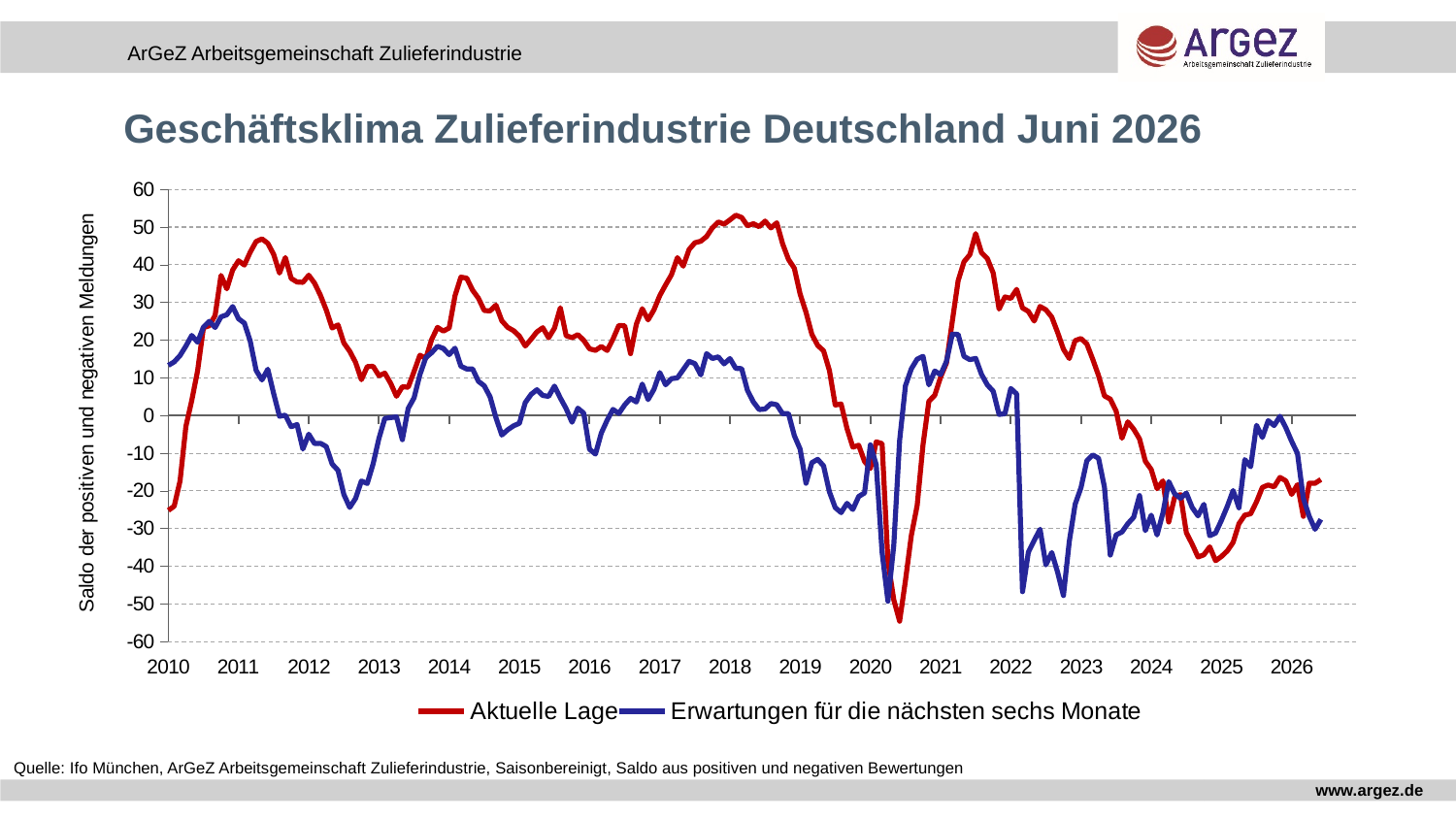
Which series is drawn in blue? Erwartungen für die nächsten sechs Monate What is the title of the chart? Geschäftsklima Zulieferindustrie Deutschland Juni 2026 How many series does the legend list? 2 Is the peak value of Aktuelle Lage in 2018 greater or less than 40? greater Does Aktuelle Lage rise or fall between its 2018 peak and early 2020? Fall What kind of chart is shown on the slide? Line chart Is the lowest value of Erwartungen für die nächsten sechs Monate in 2020 greater or less than -40? less Is the lowest value of Aktuelle Lage in 2020 greater or less than -50? less How many year labels are shown on the x axis? 17 Which series reaches the highest value anywhere on the chart? Aktuelle Lage Which series reaches the lowest value anywhere on the chart? Aktuelle Lage At the start of 2010, which series has the higher value, Aktuelle Lage or Erwartungen für die nächsten sechs Monate? Erwartungen für die nächsten sechs Monate